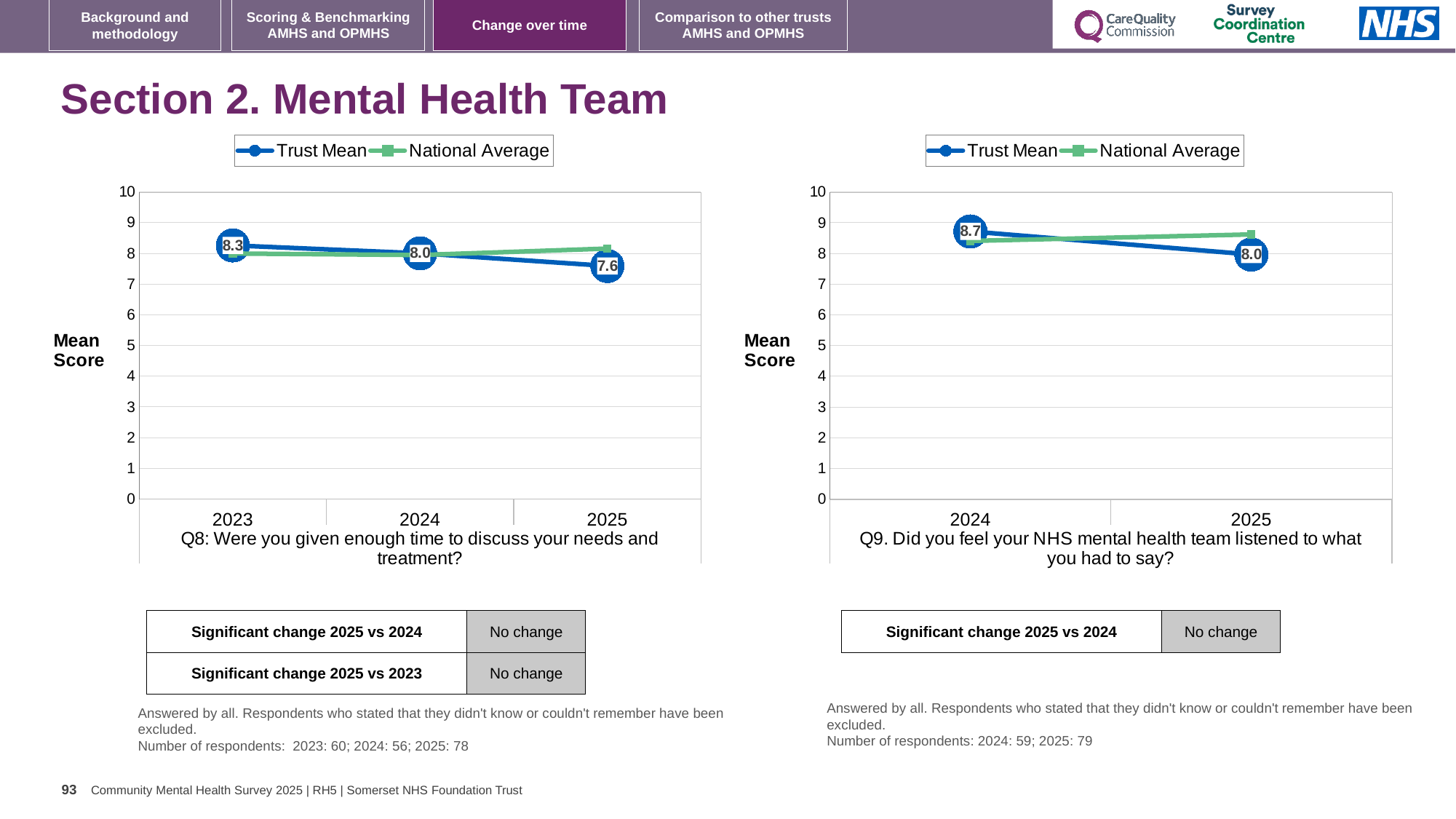
In the Q8 chart (left), what is the Trust Mean for 2025? 7.6 In the Q9 chart (right), what is the Trust Mean for 2024? 8.7 In the Q8 chart (left), does the Trust Mean rise or fall from 2023 to 2025? fall In the Q8 chart (left), which year has the lowest Trust Mean? 2025 In the Q9 chart (right), what is the difference between the Trust Mean in 2024 and 2025? 0.7 In the Q8 chart (left), by how much did the Trust Mean fall from 2023 to 2025? 0.7 In the Q9 chart (right), which year has the higher Trust Mean? 2024 In the Q9 chart (right), what is the Trust Mean for 2025? 8.0 In the Q9 chart (right), is the National Average for 2025 greater or less than 8? greater In the Q8 chart (left), what is the Trust Mean for 2023? 8.3 How many series does the legend of the Q9 chart (right) list? 2 How many years are shown on the x axis of the Q8 chart (left)? 3